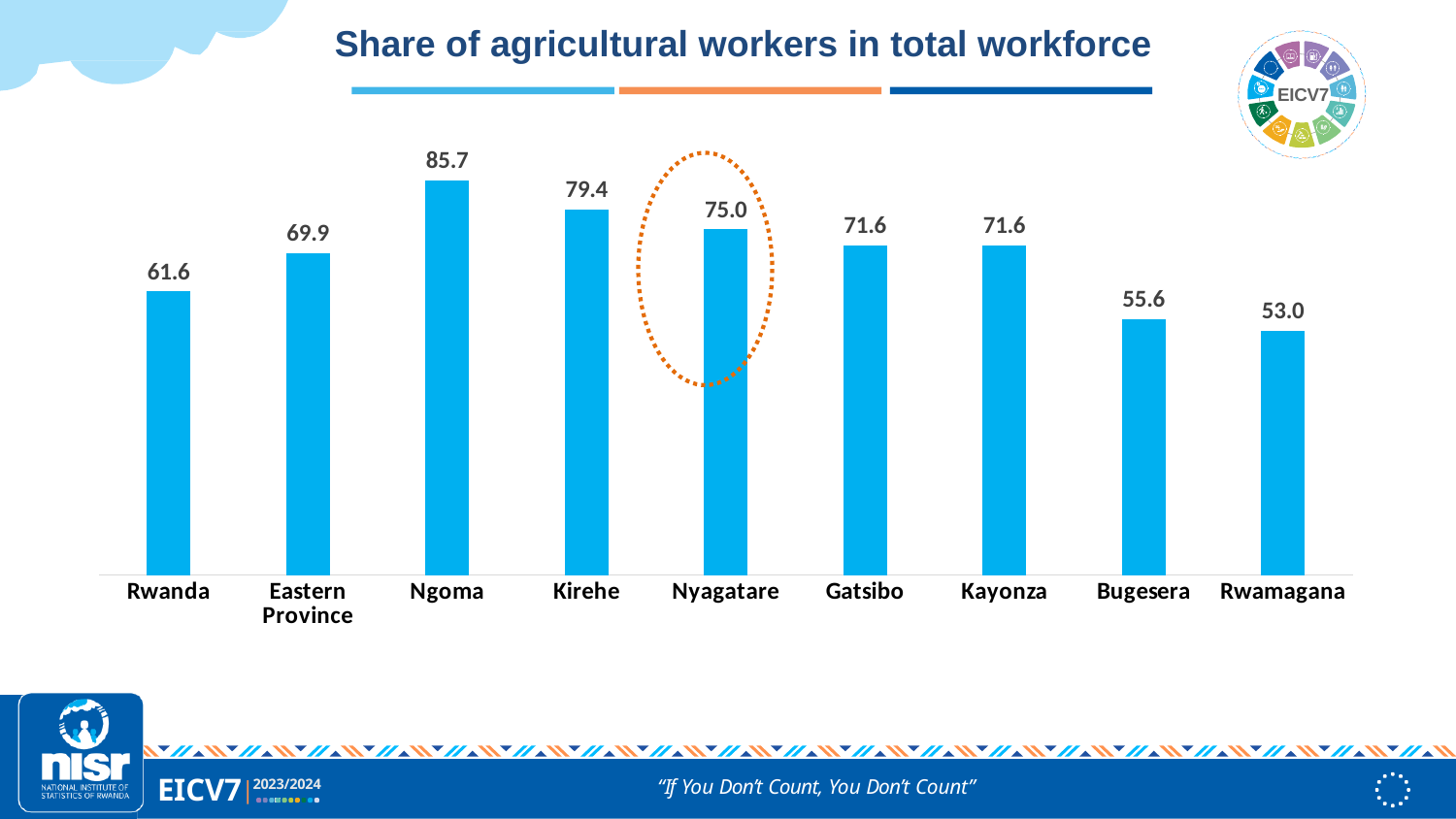
How many categories are shown on the x axis? 9 What is the share of agricultural workers in total workforce for Nyagatare? 75.0 What is the value shown for Eastern Province? 69.9 Which bar is highlighted with a dotted orange circle? Nyagatare What is the difference between the values for Kirehe and Nyagatare? 4.4 What is the title of the chart? Share of agricultural workers in total workforce Which category has the highest share of agricultural workers? Ngoma Which is larger, the value for Bugesera or the value for Rwamagana? Bugesera Which category has the lowest share of agricultural workers? Rwamagana What is the value shown for Rwanda? 61.6 What is the difference between the values for Ngoma and Rwamagana? 32.7 What kind of chart is shown on the slide? Bar chart